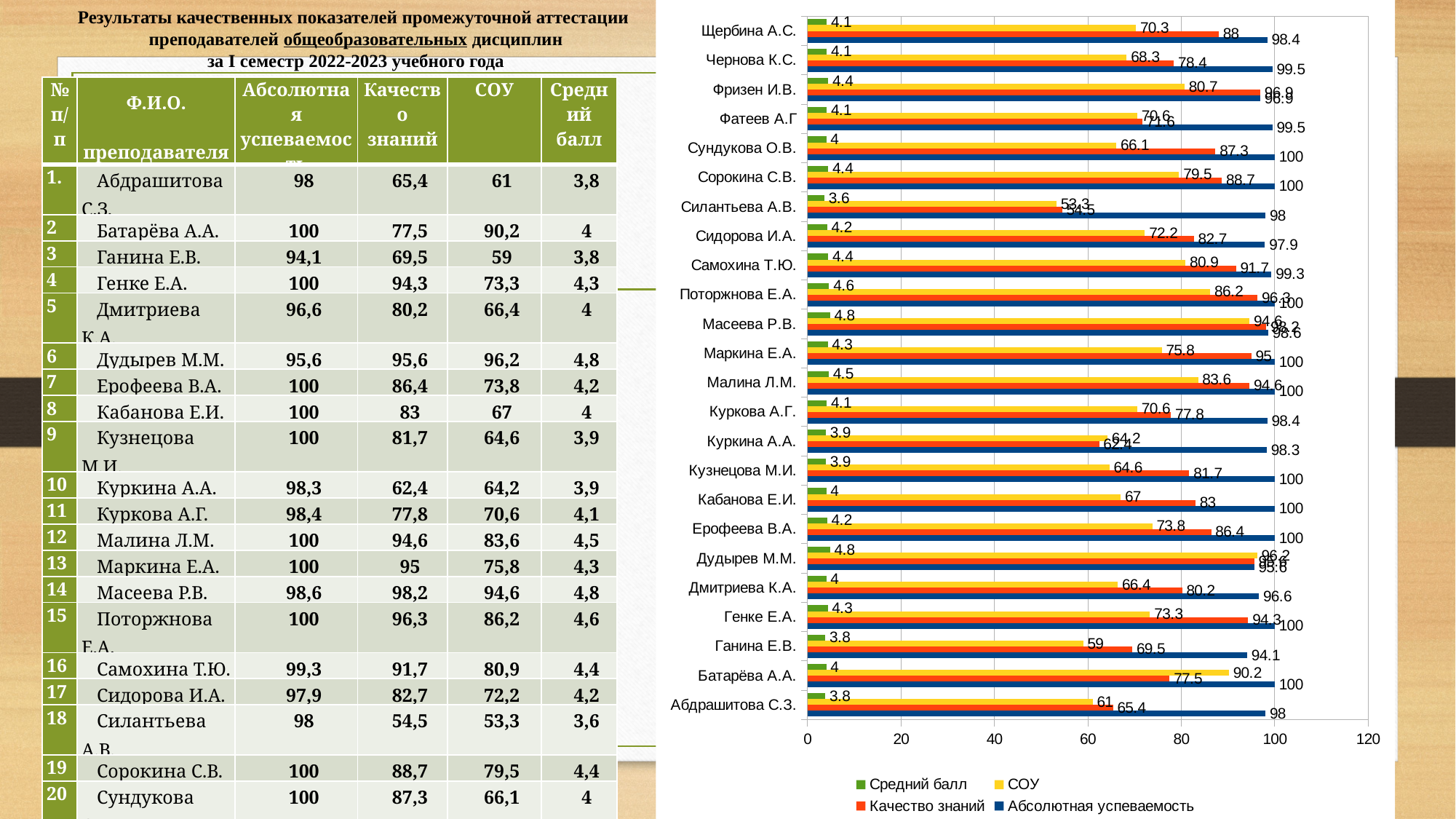
What is the Абсолютная успеваемость value for Щербина А.С. on the chart? 98.4 Which teacher has the lowest Средний балл on the chart? Силантьева А.В. What is the СОУ value for Батарёва А.А. on the chart? 90.2 What kind of chart is shown on the right side of the slide? bar chart How many series does the chart legend list? 4 Which has the larger Абсолютная успеваемость on the chart: Ганина Е.В. or Дмитриева К.А.? Дмитриева К.А. What is the Качество знаний value for Сундукова О.В. on the chart? 87.3 What is the difference between the Качество знаний and СОУ values for Щербина А.С. on the chart? 17.7 How many teachers (categories) are plotted on the chart? 24 What is the Качество знаний value for Ганина Е.В. on the chart? 69.5 Which colour represents Абсолютная успеваемость in the chart legend? blue What is the Средний балл value for Дудырев М.М. on the chart? 4.8